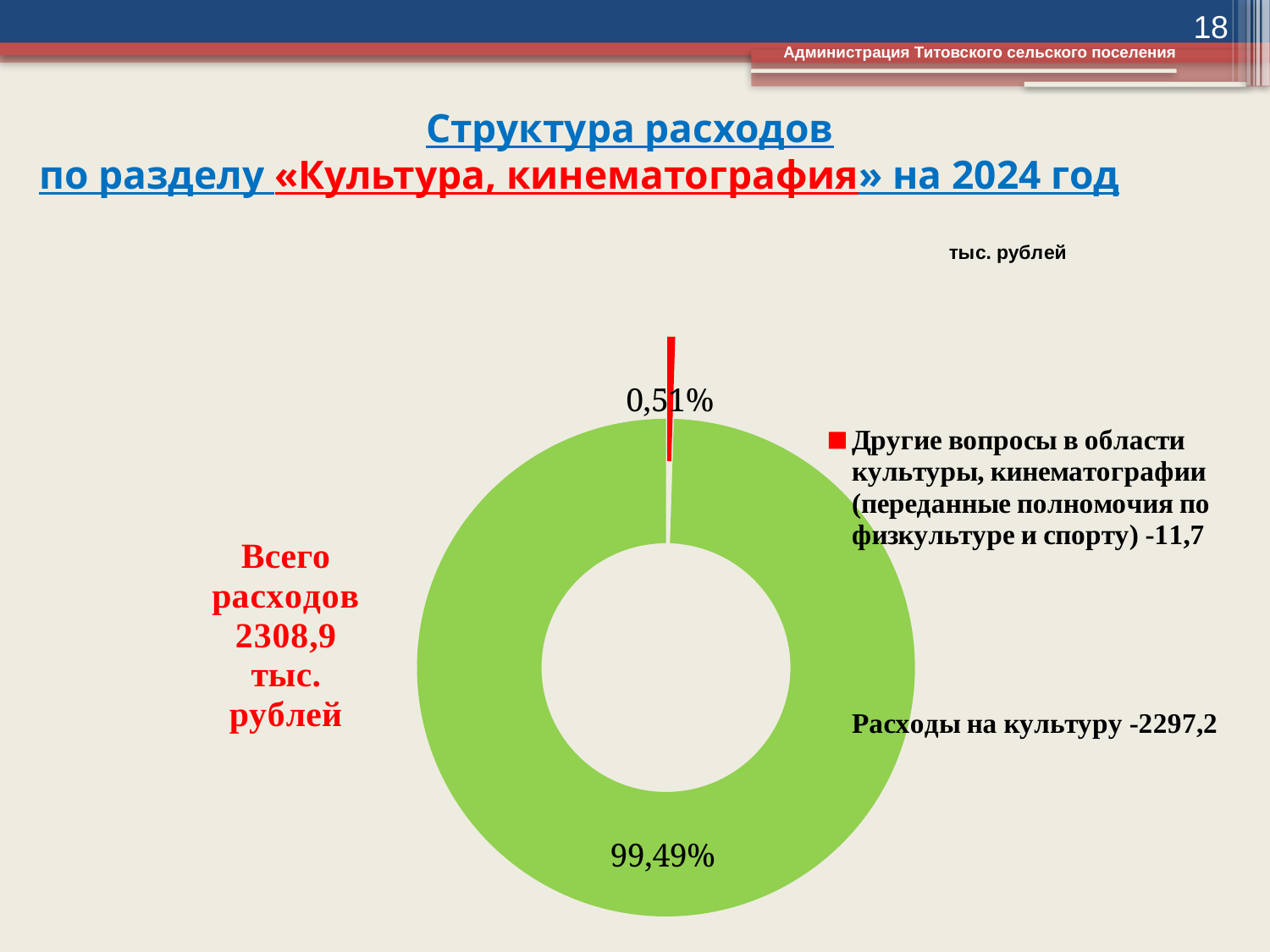
What is the difference between the values for "Расходы на культуру" and "Другие вопросы в области культуры, кинематографии" in thousand rubles? 2285,5 What percentage share does the slice "Другие вопросы в области культуры, кинематографии (переданные полномочия по физкультуре и спорту)" have? 0,51% Which is larger: the value for "Расходы на культуру" or for "Другие вопросы в области культуры, кинематографии"? Расходы на культуру What is the value for "Расходы на культуру" in thousand rubles? 2297,2 What is the total of all expenditures shown on the slide, in thousand rubles? 2308,9 Which category has the smallest share of the chart? Другие вопросы в области культуры, кинематографии (переданные полномочия по физкультуре и спорту) What is the value for "Другие вопросы в области культуры, кинематографии (переданные полномочия по физкультуре и спорту)" in thousand rubles? 11,7 What percentage share does the slice "Расходы на культуру" have? 99,49% How many slices does the chart have? 2 What kind of chart is shown on the slide? Doughnut (pie) chart Which category has the largest share of the chart? Расходы на культуру What colour is the slice for "Другие вопросы в области культуры, кинематографии (переданные полномочия по физкультуре и спорту)"? Red